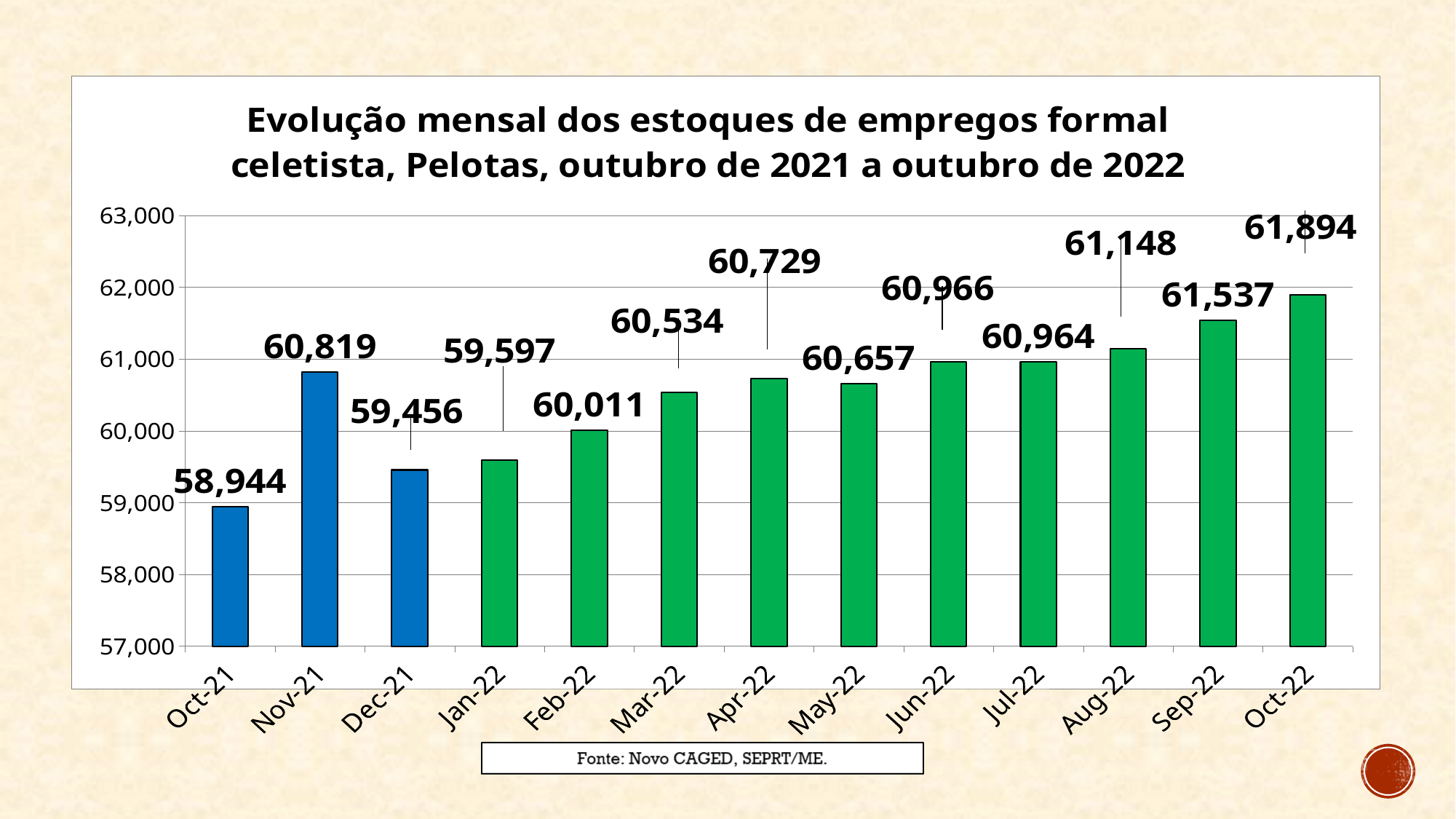
What is the difference between the values for Oct-22 and Oct-21? 2,950 Which is larger, the value for Nov-21 or the value for Feb-22? Nov-21 What is the difference between the values for Nov-21 and Dec-21? 1,363 Which month has the highest value? Oct-22 What is the value for Oct-21? 58,944 What kind of chart is shown on the slide? bar chart How many months are shown on the x axis? 13 Which month has the lowest value? Oct-21 What colour are the bars for the 2021 months (Oct-21 to Dec-21)? blue What is the value for Sep-22? 61,537 Is the value for Sep-22 greater or less than 61,000? greater What is the value for Apr-22? 60,729